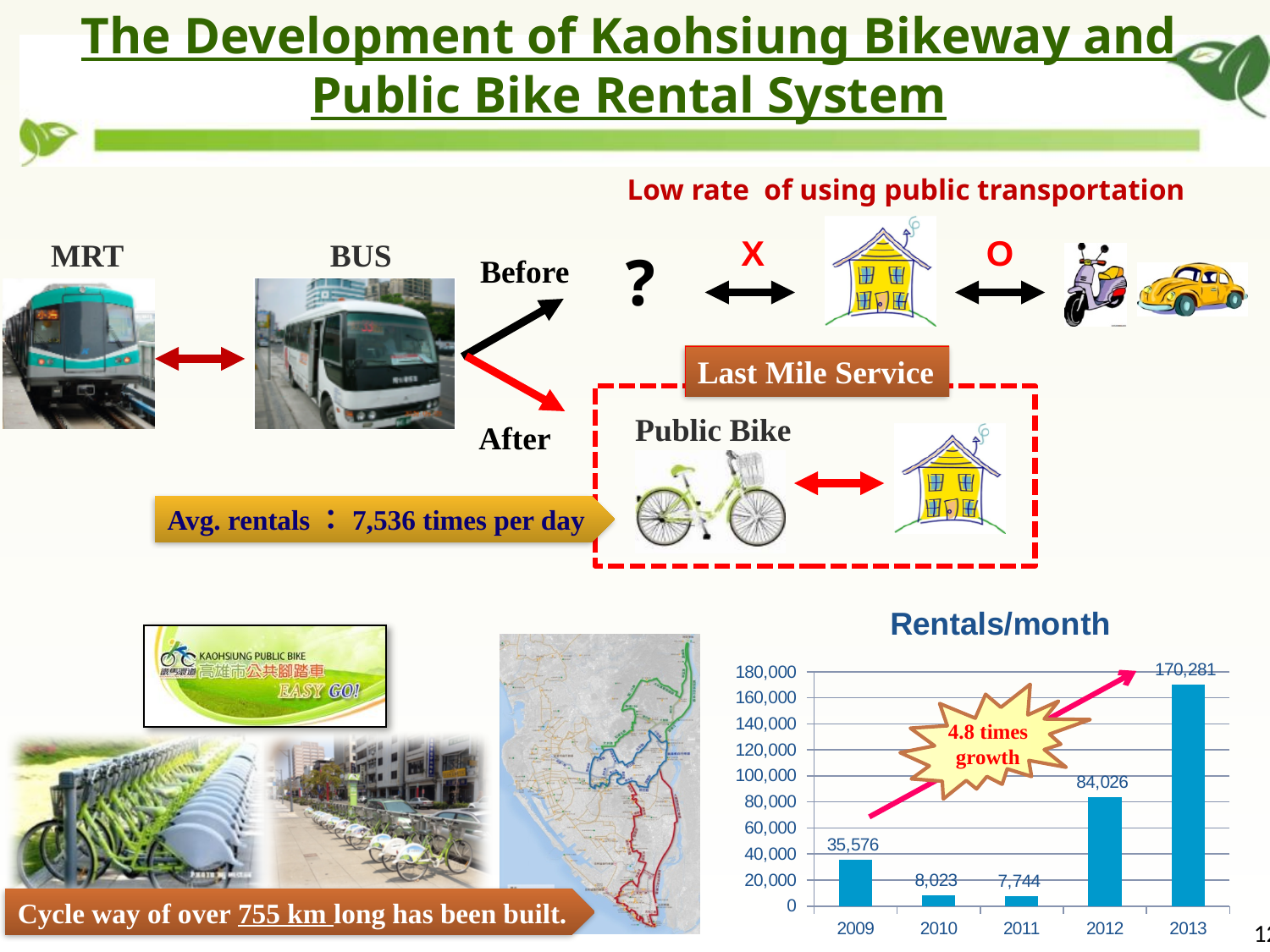
What type of chart is shown under the title "Rentals/month"? bar chart What is the value for 2011 in the Rentals/month chart? 7,744 In the Rentals/month chart, what is the difference between the 2013 value and the 2012 value? 86,255 In the Rentals/month chart, which is larger, the value for 2009 or the value for 2010? 2009 What is the value for 2009 in the Rentals/month chart? 35,576 Which year has the lowest value in the Rentals/month chart? 2011 In the Rentals/month chart, is the value for 2012 greater or less than 100,000? less What growth factor is written in the starburst callout on the Rentals/month chart? 4.8 times growth How many years are shown on the x axis of the Rentals/month chart? 5 What is the value for 2013 in the Rentals/month chart? 170,281 Which year has the highest value in the Rentals/month chart? 2013 What is the title of the chart on the slide? Rentals/month